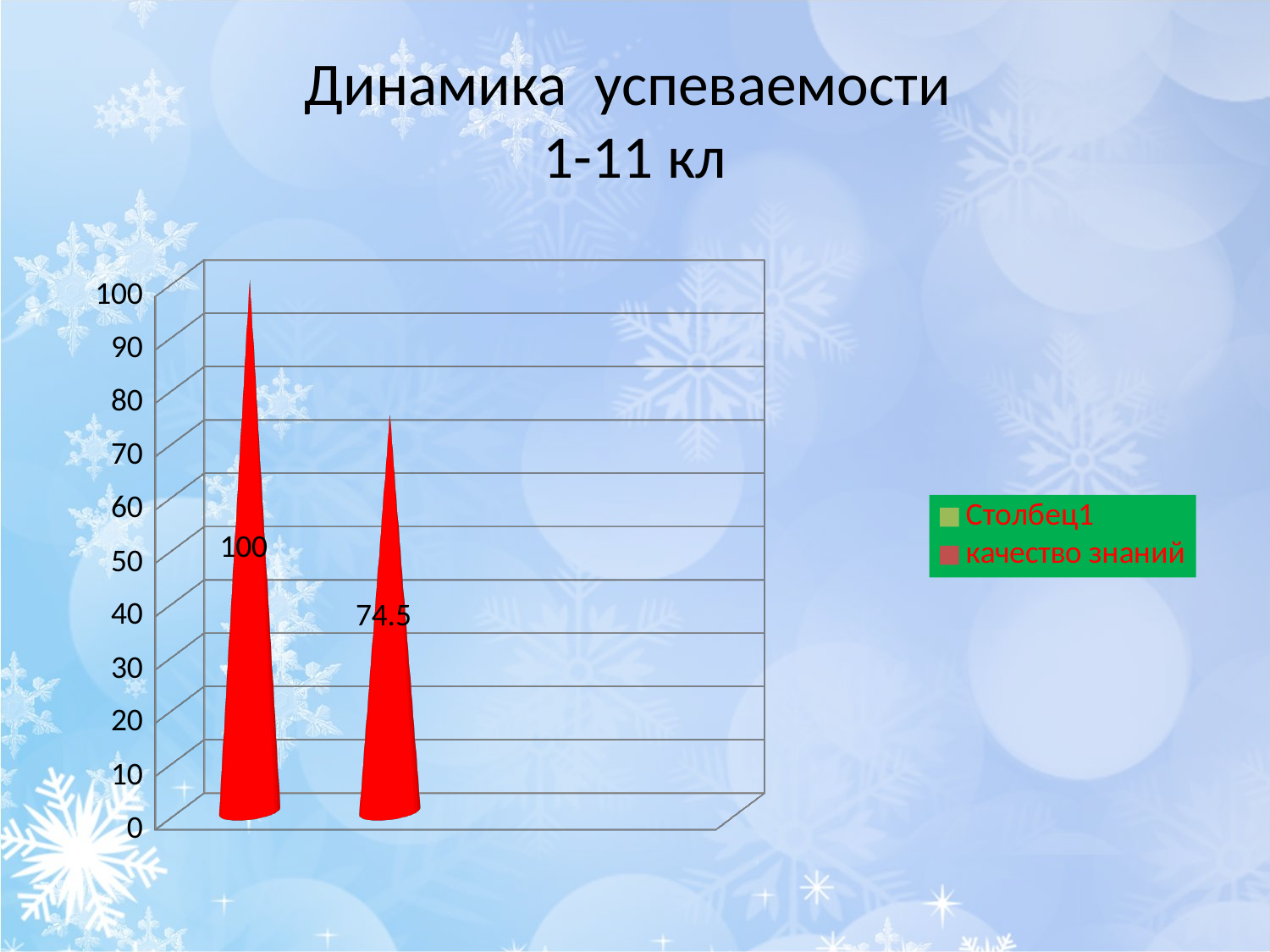
How many entries does the legend list? 2 What is the highest value labelled on the vertical axis? 100 What is the value shown on the right bar of the chart? 74.5 What is the difference between the values of the left bar (100) and the right bar (74.5)? 25.5 Which bar is taller, the left one or the right one? the left one What is the second entry listed in the legend? качество знаний Is the value of the right bar greater or less than 70? greater What is the title of the chart on the slide? Динамика успеваемости 1-11 кл Do the values rise or fall from the left bar to the right bar? fall What kind of chart is shown on the slide? bar chart What is the value shown on the left bar of the chart? 100 How many bars are plotted in the chart? 2